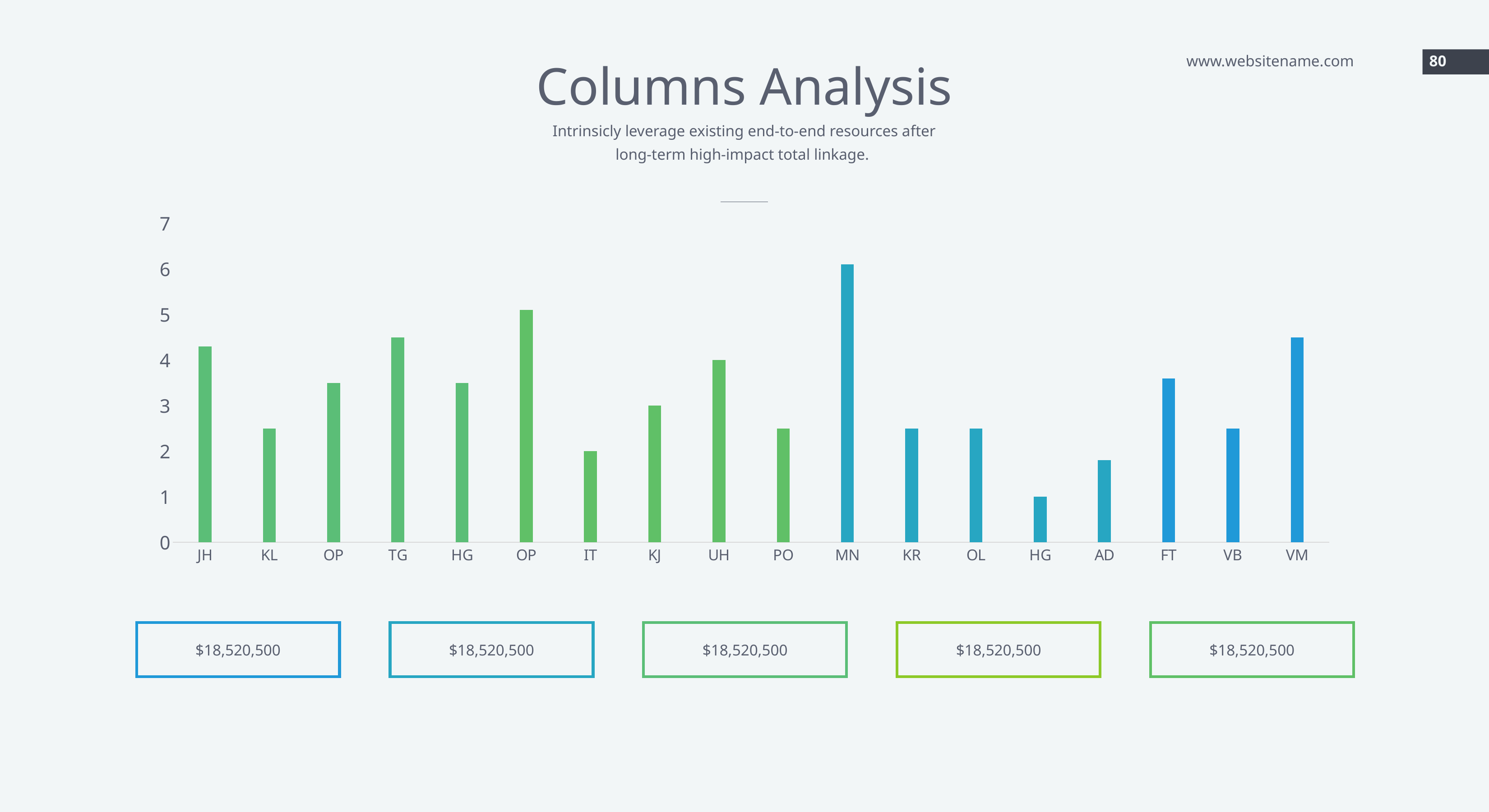
How many categories are plotted along the x axis of the chart? 18 Is the value for VM greater or less than 4? greater Which is larger, the value for UH or the value for IT? UH Is the value for MN greater or less than 5? greater What is the title of the chart on the slide? Columns Analysis Which is larger, the value for MN or the value for VM? MN Is the value for KL greater or less than 3? less Which is larger, the value for JH or the value for KL? JH Which category has the highest bar in the chart? MN What type of chart is shown on the slide? bar chart Which category has the lowest bar in the chart? HG